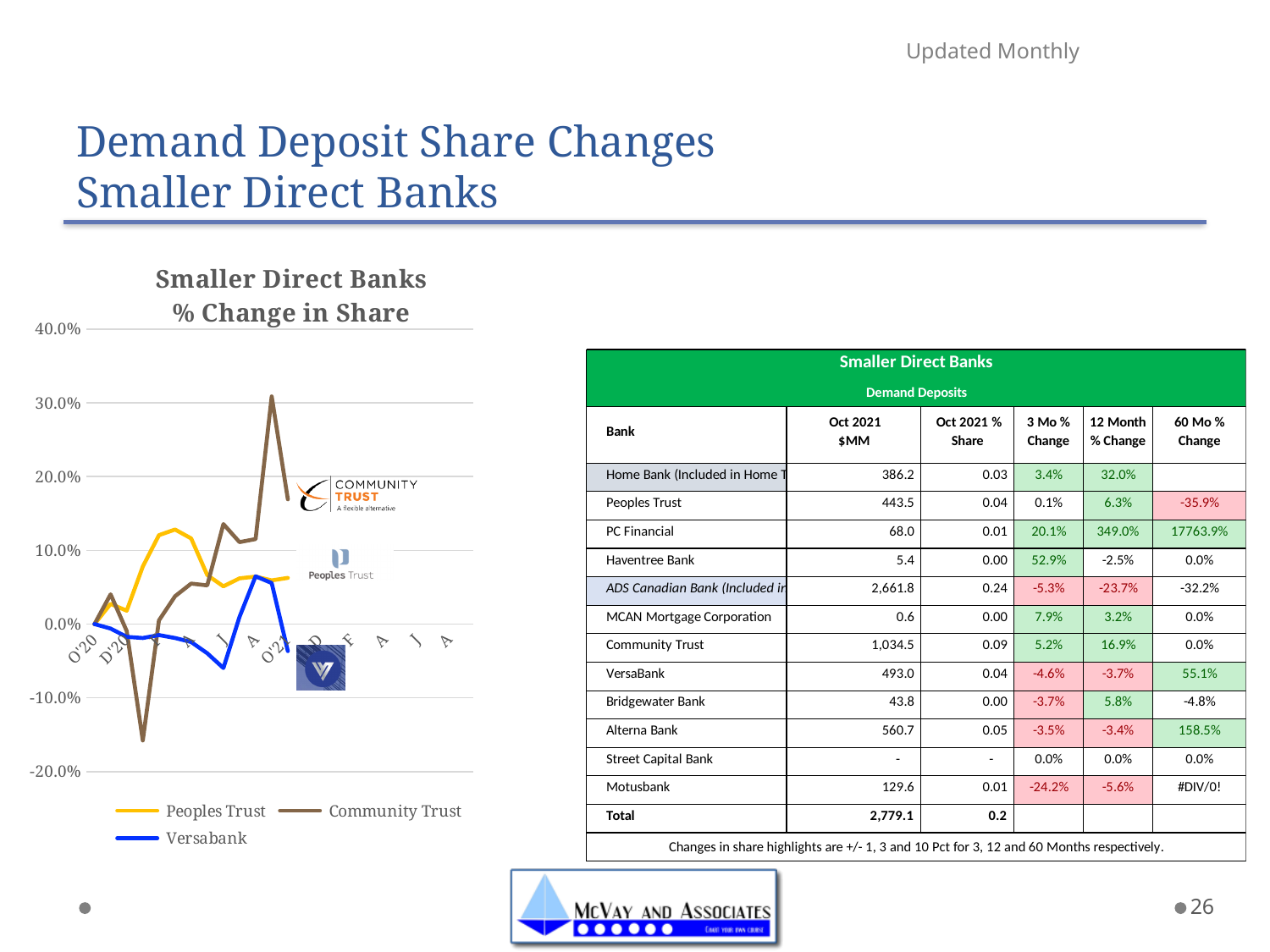
Which series reaches the highest value on the chart? Community Trust What kind of chart is shown on the slide? line chart Which series reaches the lowest value on the chart? Community Trust Which series are listed in the chart's legend? Peoples Trust, Community Trust, Versabank Is the peak value for Community Trust greater or less than 20.0%? greater Is the highest value reached by Versabank greater or less than 10.0%? less What is the title of the chart? Smaller Direct Banks % Change in Share At the last plotted point, which series has the highest value? Community Trust How many series does the chart's legend list? 3 Is the lowest value for Community Trust greater or less than -10.0%? less What is the highest value shown on the chart's y axis? 40.0%